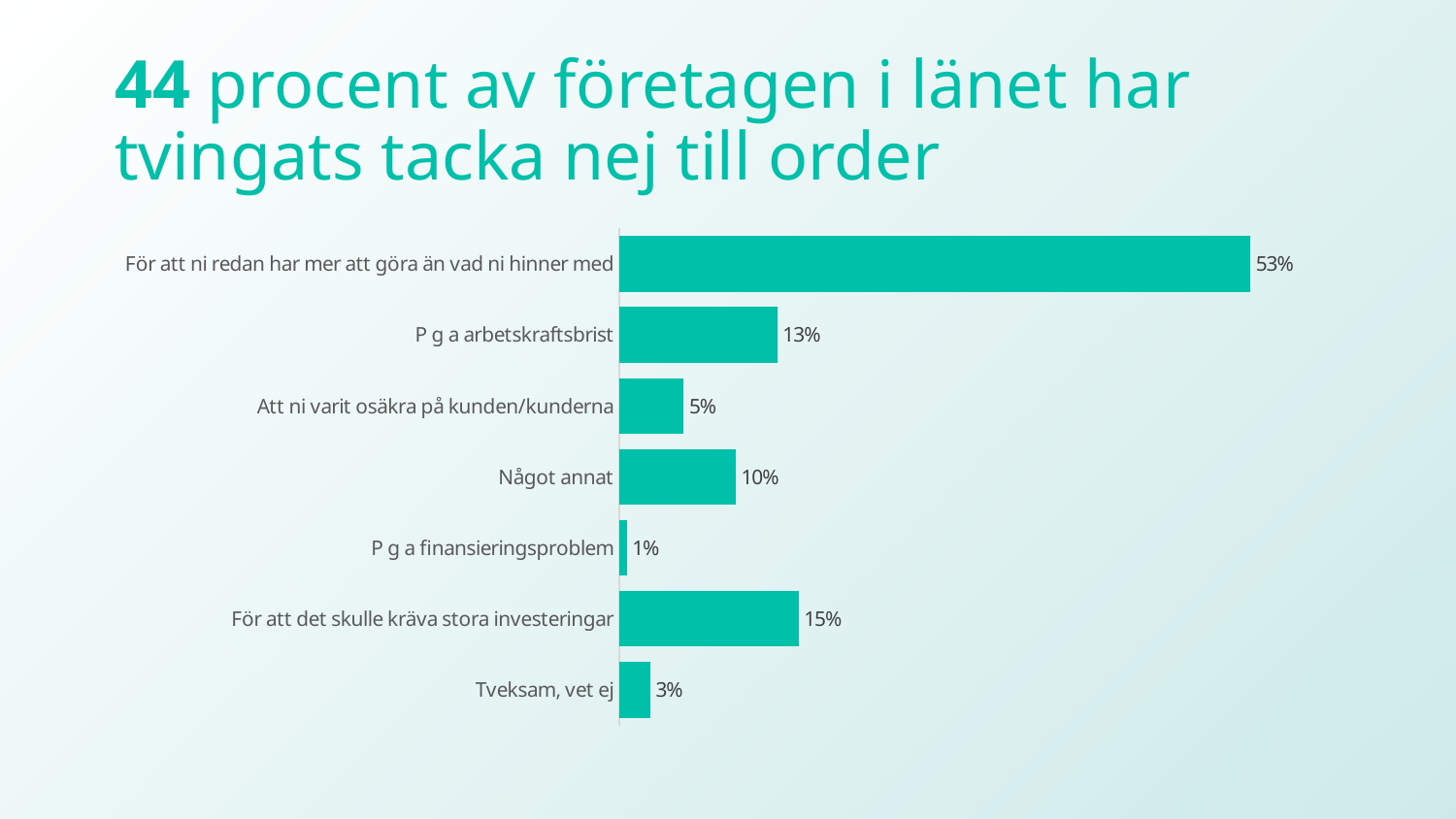
Which category has the highest value? För att ni redan har mer att göra än vad ni hinner med Which is larger, the value for "Något annat" or the value for "Att ni varit osäkra på kunden/kunderna"? Något annat Which category has the lowest value? P g a finansieringsproblem How many categories are shown in the chart? 7 What is the value for "Tveksam, vet ej"? 3% What is the value for "Något annat"? 10% What is the difference between the values for "För att ni redan har mer att göra än vad ni hinner med" and "P g a arbetskraftsbrist"? 40% What is the difference between the values for "För att det skulle kräva stora investeringar" and "Att ni varit osäkra på kunden/kunderna"? 10% What is the value for "För att det skulle kräva stora investeringar"? 15% What is the title of the slide? 44 procent av företagen i länet har tvingats tacka nej till order What is the value for "P g a arbetskraftsbrist"? 13% What kind of chart is shown on the slide? Bar chart